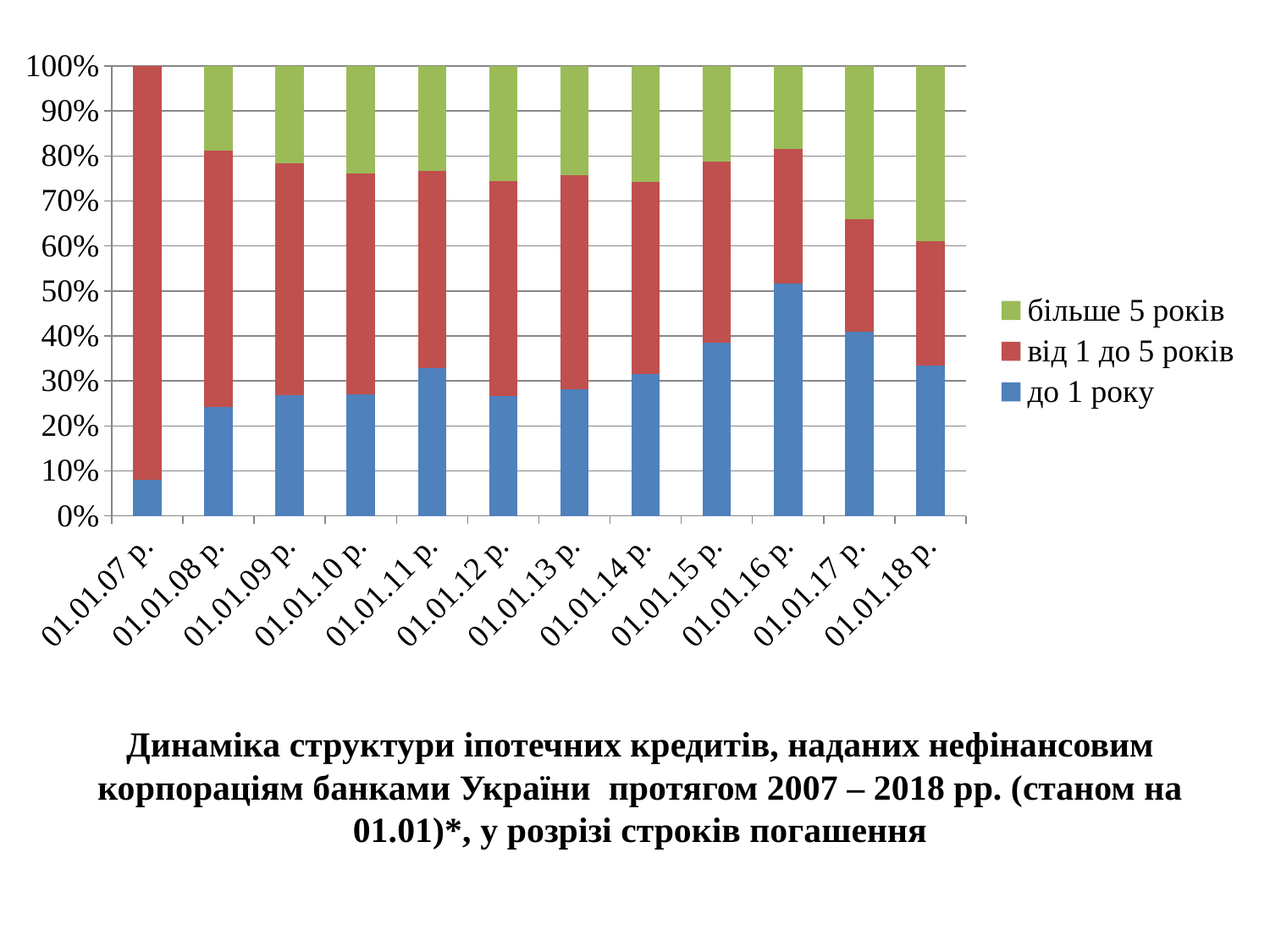
How many dates (categories) are shown along the x axis? 12 Which date has the larger share of "до 1 року": 01.01.16 р. or 01.01.17 р.? 01.01.16 р. Which date has the largest share for the series "більше 5 років"? 01.01.18 р. How many series does the legend list? 3 Is the share of "до 1 року" at 01.01.16 р. greater or less than 40%? greater Which date has the lowest share for the series "до 1 року"? 01.01.07 р. Which date has the larger share of "більше 5 років": 01.01.08 р. or 01.01.17 р.? 01.01.17 р. Which date has the highest share for the series "до 1 року"? 01.01.16 р. Is the share of "від 1 до 5 років" at 01.01.07 р. greater or less than 80%? greater Which colour represents the series "до 1 року" in the legend? Blue What kind of chart is shown on the slide? Stacked bar chart Is the share of "до 1 року" at 01.01.07 р. greater or less than 20%? less